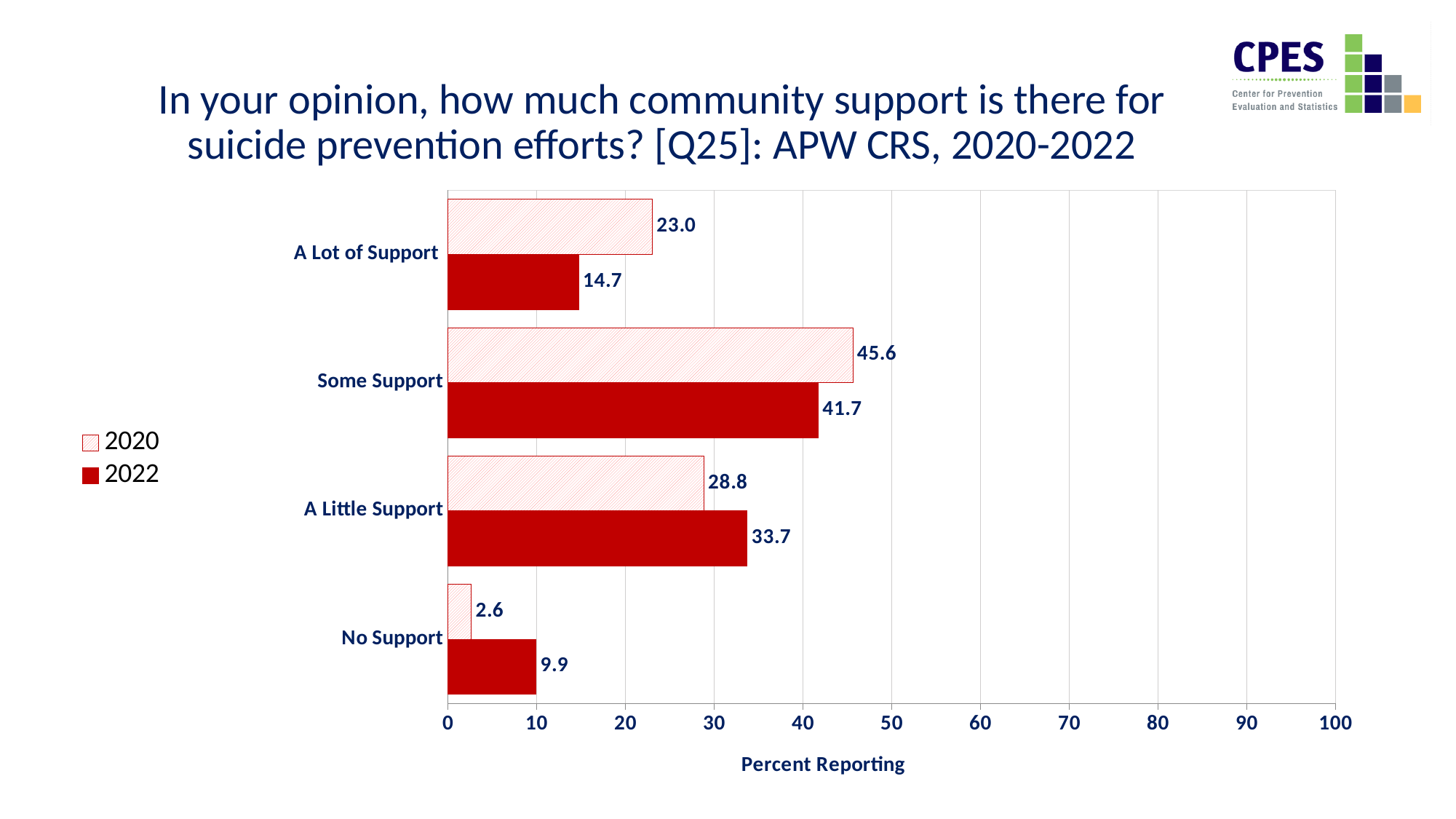
Which is larger for Some Support, the 2020 value or the 2022 value? 2020 Which category has the highest 2022 value? Some Support Which category has the lowest 2020 value? No Support What is the difference between the 2020 and 2022 values for A Lot of Support? 8.3 What kind of chart is shown on the slide? Bar chart How many categories are shown on the chart? 4 Is the 2022 value for A Little Support greater or less than 30? greater What is the difference between the 2022 and 2020 values for A Little Support? 4.9 What is the 2020 value for Some Support? 45.6 How many series does the legend list? 2 What is the 2022 value for No Support? 9.9 What is the 2022 value for A Lot of Support? 14.7